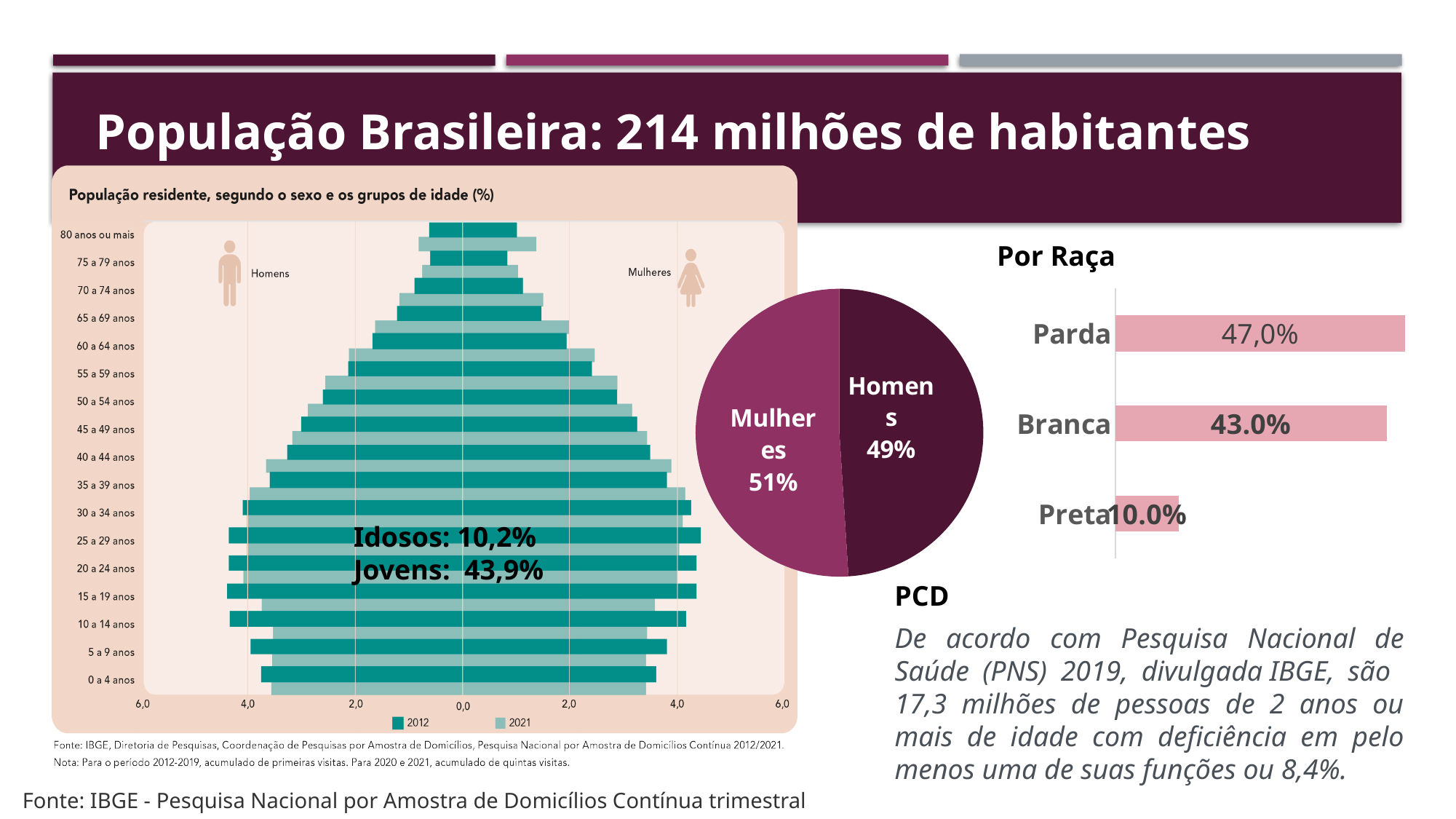
In the 'Por Raça' bar chart, which category has the lowest value? Preta In the population pyramid chart on the left, how many series does the legend list? 2 In the 'Por Raça' bar chart, what is the difference between the values for Branca and Preta? 33.0 percentage points In the 'Por Raça' bar chart, how many categories are shown? 3 In the population pyramid chart on the left, how many age groups are shown on the vertical axis? 17 In the 'Por Raça' bar chart, what is the value for Preta? 10.0% In the 'Por Raça' bar chart, which category has the highest value? Parda In the pie chart, which slice is larger, Mulheres or Homens? Mulheres In the 'Por Raça' bar chart, what is the value for Parda? 47,0% In the 'Por Raça' bar chart, what is the value for Branca? 43.0% What kind of chart is the chart in the middle of the slide showing Mulheres and Homens? Pie chart In the pie chart, what share is shown for Mulheres? 51%